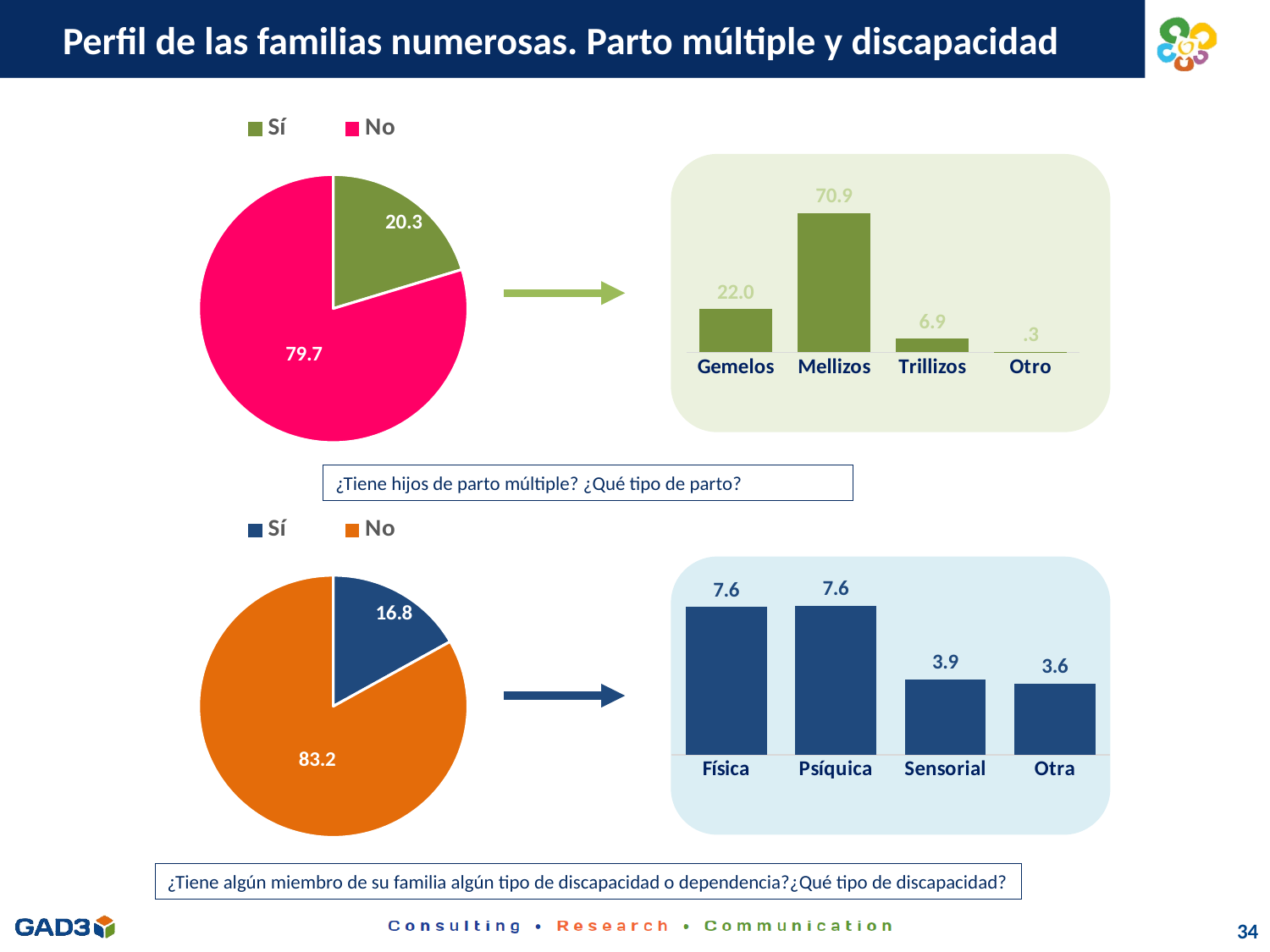
In the top-right bar chart, how many categories are shown? 4 In the bottom-left pie chart, what is the value for "Sí"? 16.8 In the top-right bar chart, what is the value for Mellizos? 70.9 In the bottom-left pie chart, which slice is larger, "Sí" or "No"? No In the bottom-right bar chart, what is the value for Sensorial? 3.9 In the top-right bar chart, what is the difference between the values for Mellizos and Gemelos? 48.9 What kind of chart is the bottom-right chart? Bar chart In the top-right bar chart, which category has the lowest value? Otro In the top-left pie chart, what is the value for "No"? 79.7 In the top-right bar chart, which category has the highest value? Mellizos In the top-left pie chart, what is the value for "Sí"? 20.3 In the bottom-right bar chart, what is the difference between the values for Física and Otra? 4.0